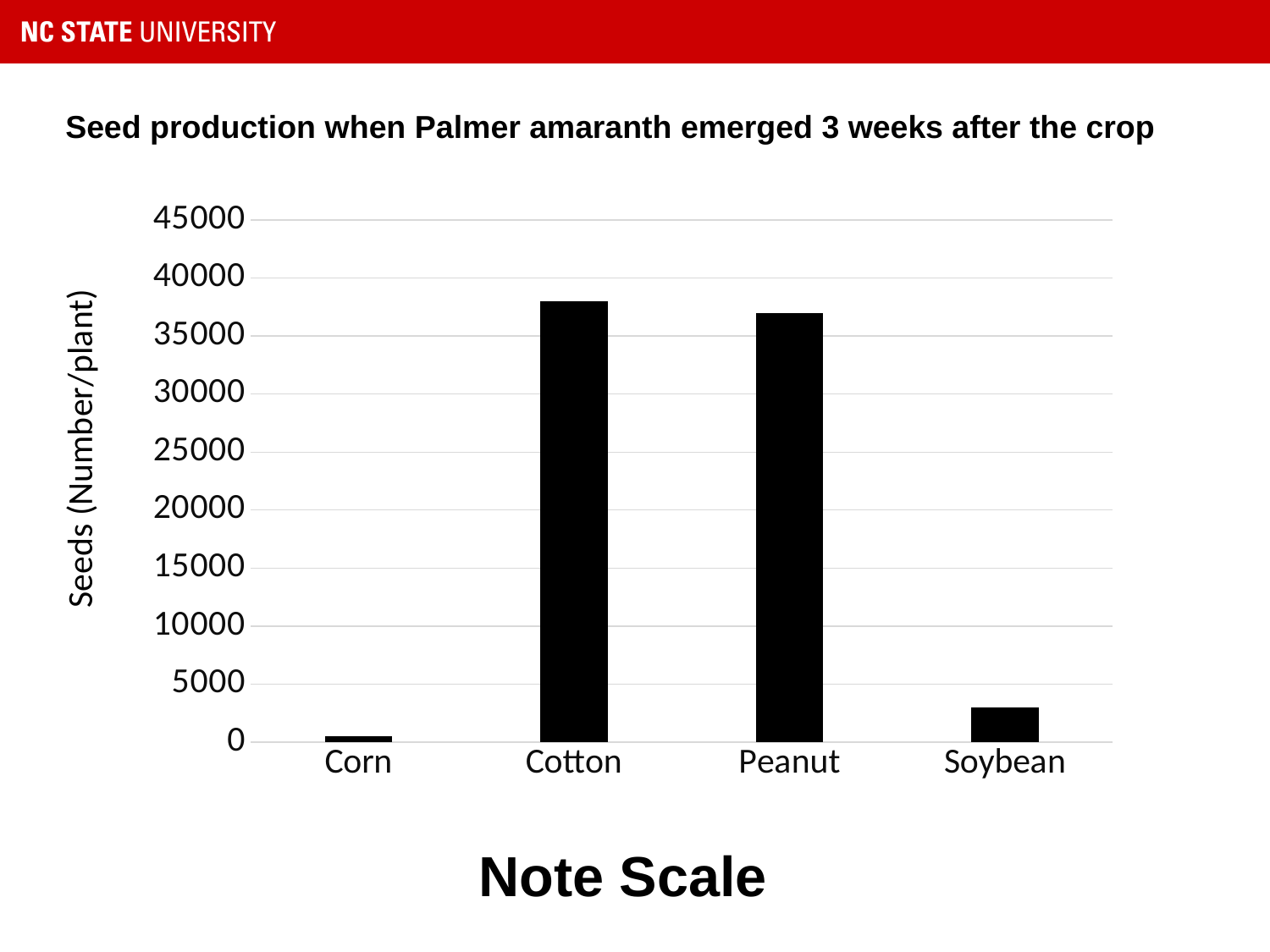
How many crop categories are shown on the x axis? 4 Is the value for Corn greater or less than 5000? less What is the label of the y axis? Seeds (Number/plant) Which is larger, the value for Cotton or the value for Soybean? Cotton Is the value for Peanut greater or less than 35000? greater What is the title of the chart? Seed production when Palmer amaranth emerged 3 weeks after the crop Is the value for Cotton greater or less than 35000? greater Which crop has the lowest Palmer amaranth seed production? Corn What kind of chart is shown on the slide? bar chart Which is larger, the value for Soybean or the value for Corn? Soybean